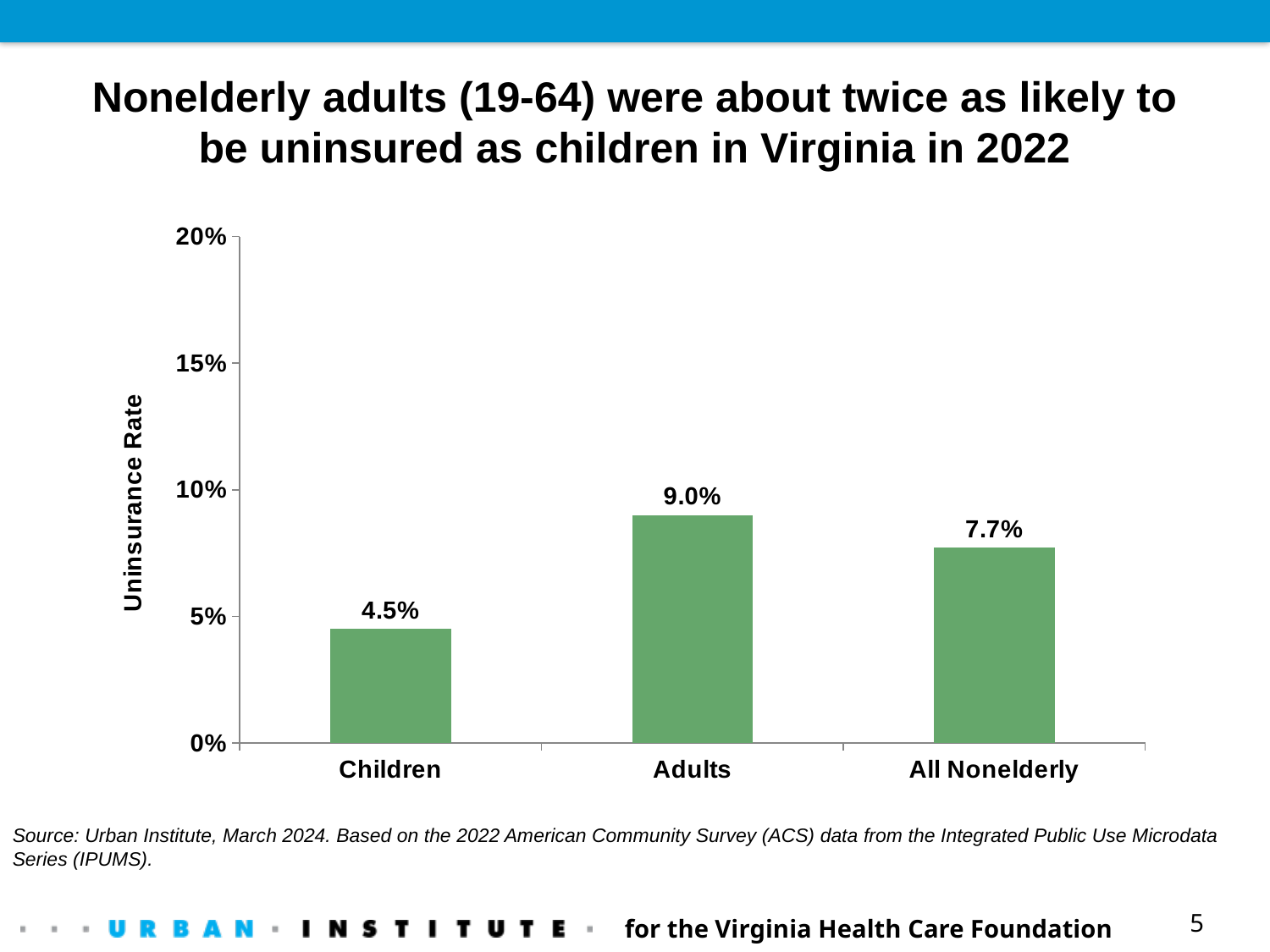
Which category has the lowest uninsurance rate? Children What is the difference in uninsurance rate between Adults and All Nonelderly? 1.3% What is the difference in uninsurance rate between Adults and Children? 4.5% Which category has the highest uninsurance rate? Adults Is the uninsurance rate for Adults greater or less than 10%? less What is the label of the vertical axis? Uninsurance Rate How many categories are shown on the chart? 3 Which has a higher uninsurance rate, Children or All Nonelderly? All Nonelderly What is the uninsurance rate for Children? 4.5% What is the uninsurance rate for All Nonelderly? 7.7% What is the uninsurance rate for Adults? 9.0% What kind of chart is shown on the slide? bar chart